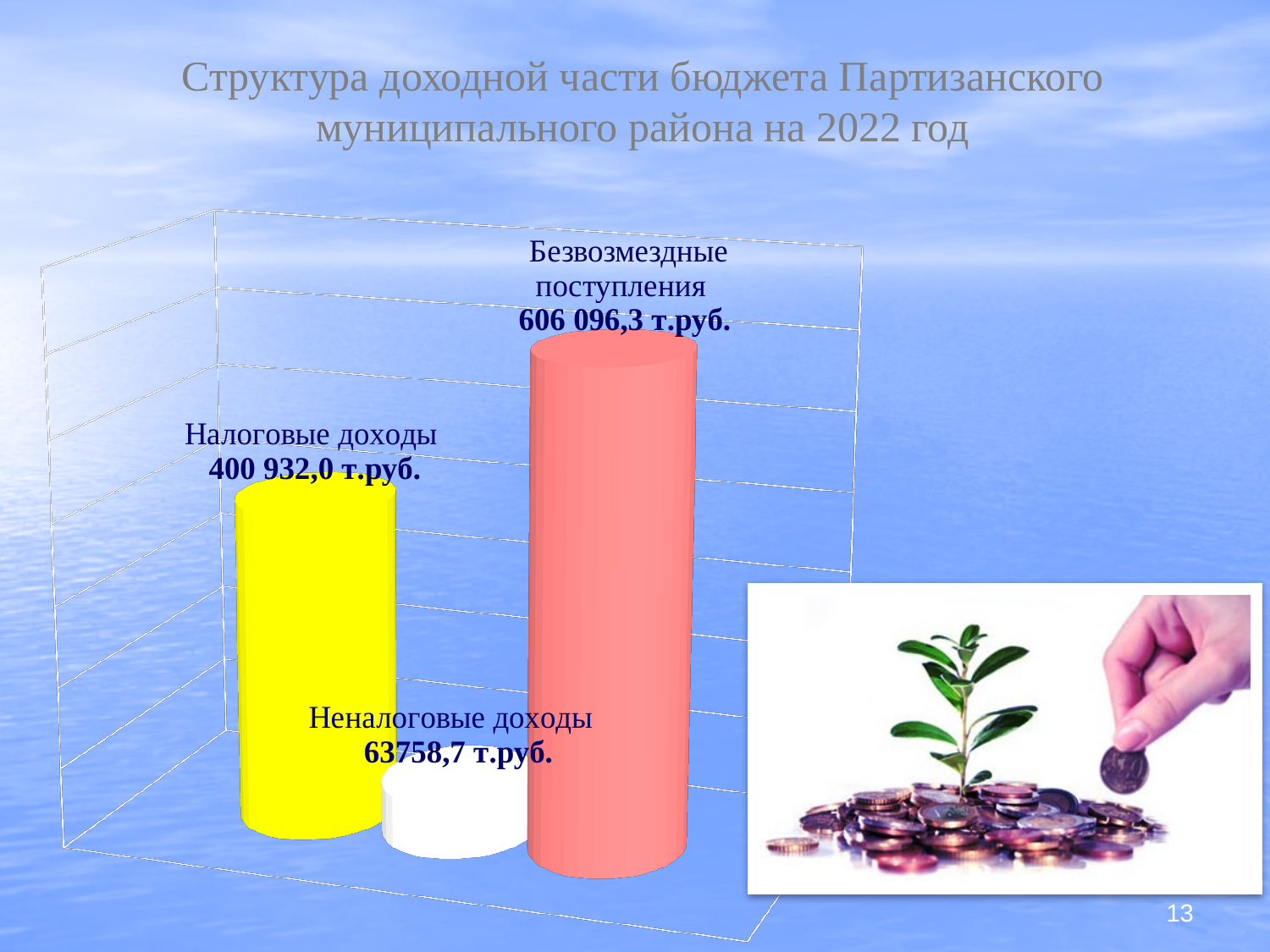
What kind of chart is shown on the slide? Bar chart What is the value for Неналоговые доходы? 63758,7 т.руб. What is the title of the slide? Структура доходной части бюджета Партизанского муниципального района на 2022 год Which is larger, Налоговые доходы or Неналоговые доходы? Налоговые доходы What is the difference between Безвозмездные поступления and Налоговые доходы? 205 164,3 т.руб. What is the value for Налоговые доходы? 400 932,0 т.руб. What is the difference between Налоговые доходы and Неналоговые доходы? 337 173,3 т.руб. What is the value for Безвозмездные поступления? 606 096,3 т.руб. How many categories are shown in the chart? 3 Which category has the highest value? Безвозмездные поступления What colour is the bar for Безвозмездные поступления? Red (pink) Which category has the lowest value? Неналоговые доходы